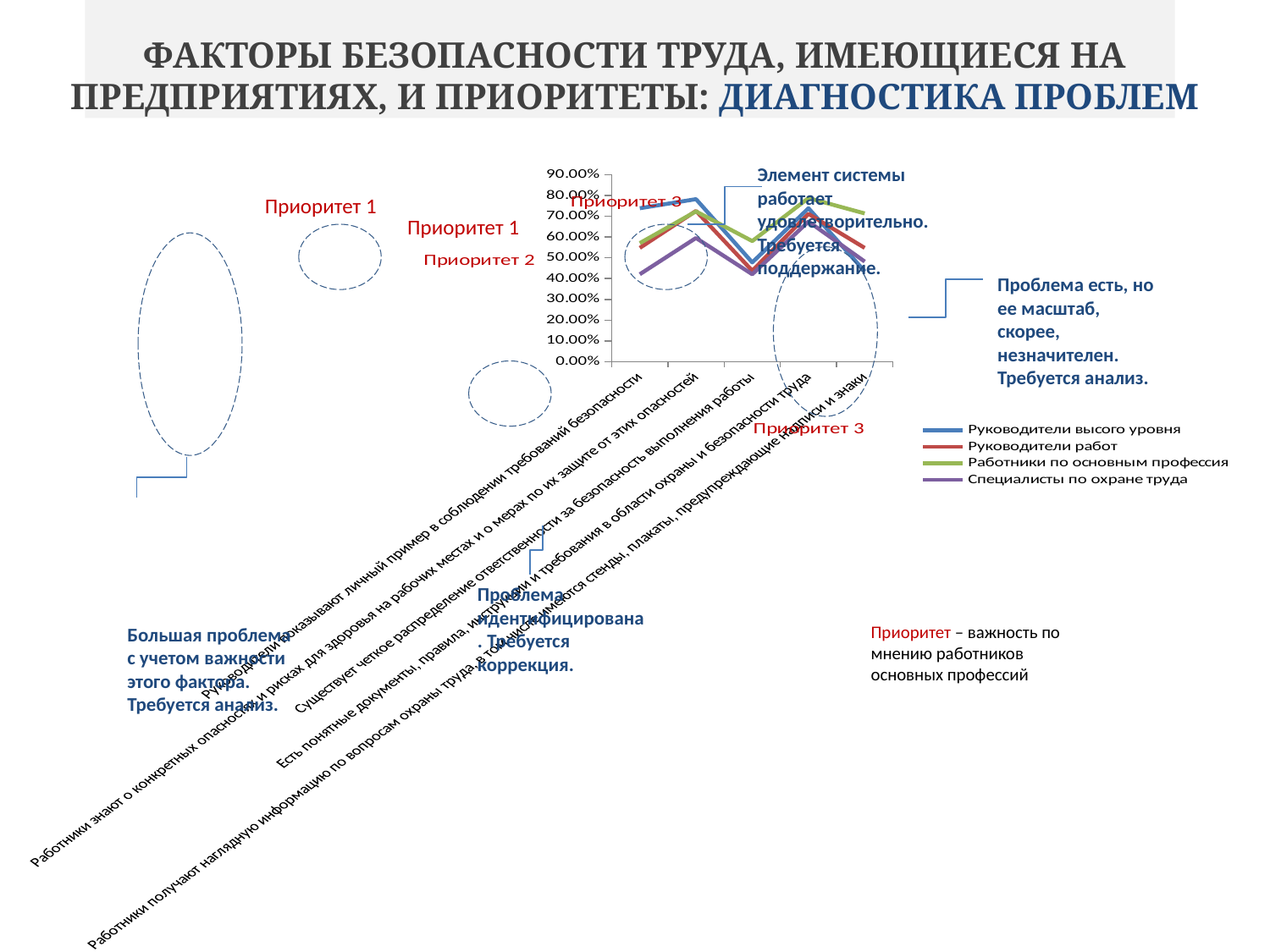
Is the value for Специалисты по охране труда at the first category greater or less than 50%? less Which series has the highest value at the last (fifth) category? Работники по основным профессиям Is the value for Работники по основным профессиям at the last category greater or less than 60%? greater How many categories are plotted along the x axis of the chart? 5 What kind of chart is shown on the slide? line chart Is the value for Руководители высокого уровня at the second category greater or less than 70%? greater Which series has the lowest value at the first category? Специалисты по охране труда Which legend entry is drawn in green on the chart? Работники по основным профессия Does the line for Специалисты по охране труда rise or fall from the first category to the second? rise How many series does the chart legend list? 4 What is the highest tick value shown on the chart's y axis? 90.00% At the third category, which is larger: the value for Руководители высокого уровня or for Специалисты по охране труда? Руководители высокого уровня